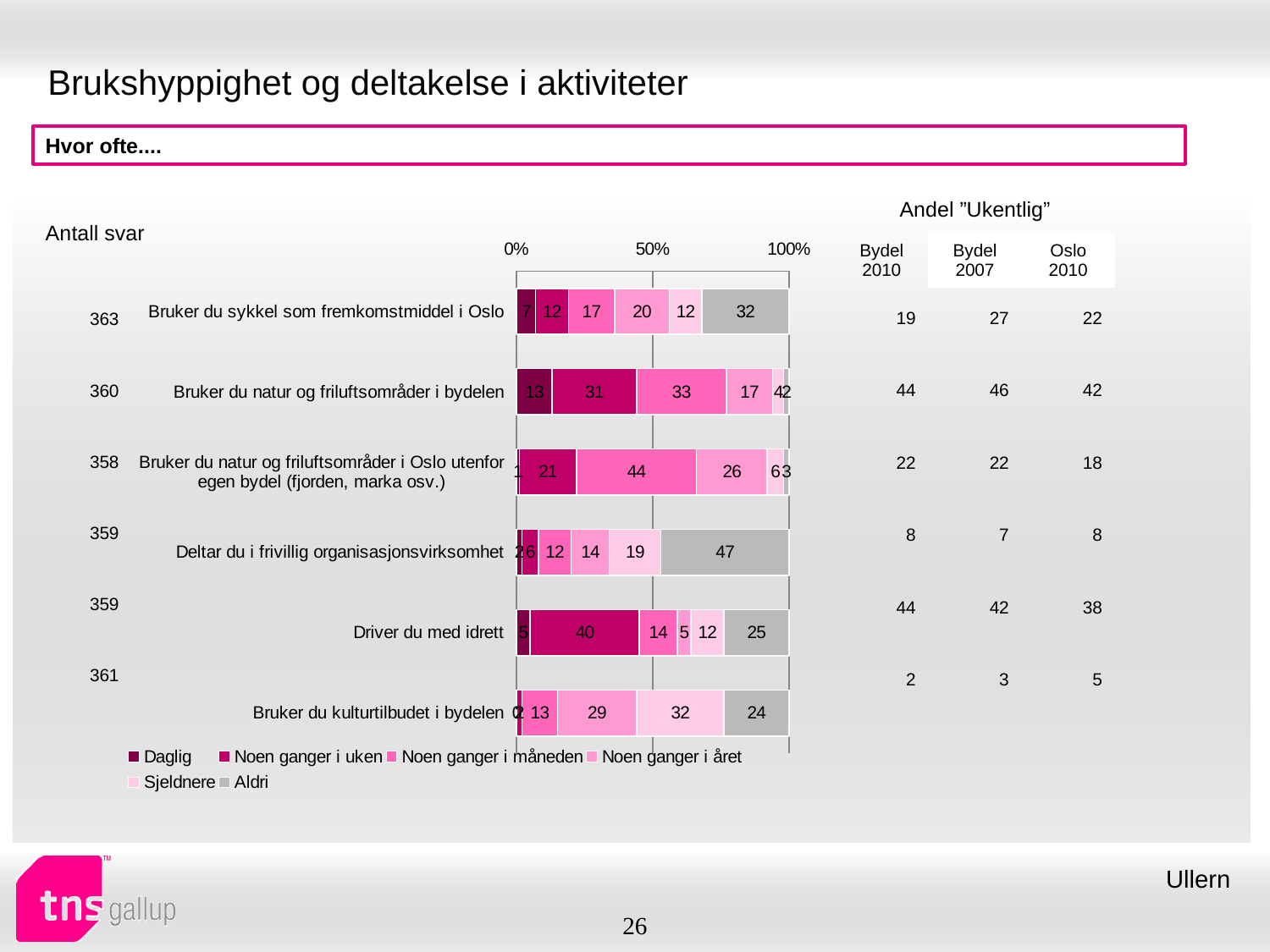
What is the 'Aldri' value for 'Deltar du i frivillig organisasjonsvirksomhet'? 47 What is the difference between the 'Aldri' values for 'Deltar du i frivillig organisasjonsvirksomhet' and 'Bruker du sykkel som fremkomstmiddel i Oslo'? 15 How many series does the chart legend list? 6 What is the 'Noen ganger i måneden' value for 'Bruker du natur og friluftsområder i Oslo utenfor egen bydel (fjorden, marka osv.)'? 44 Which category has the largest 'Aldri' segment? Deltar du i frivillig organisasjonsvirksomhet Which series is listed first in the chart legend? Daglig What is the 'Aldri' value for 'Bruker du sykkel som fremkomstmiddel i Oslo'? 32 What is the 'Noen ganger i uken' value for 'Driver du med idrett'? 40 What is the 'Noen ganger i uken' value for 'Bruker du natur og friluftsområder i bydelen'? 31 Which is larger: the 'Noen ganger i uken' value for 'Driver du med idrett' or for 'Bruker du sykkel som fremkomstmiddel i Oslo'? Driver du med idrett What kind of chart is shown on the slide? Stacked bar chart How many activity categories are plotted in the chart? 6